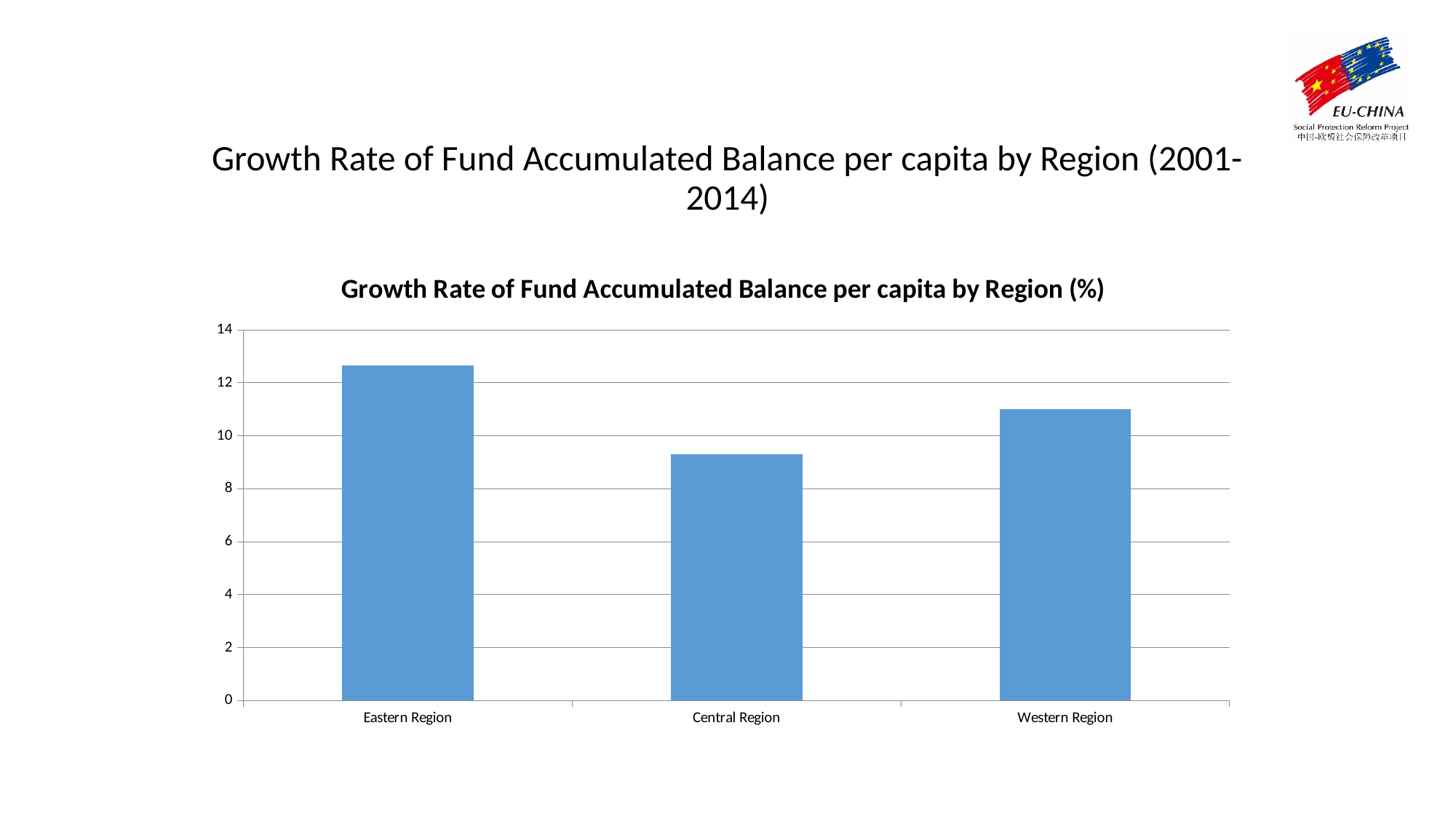
How many regions are plotted in the chart? 3 What kind of chart is shown on the slide? bar chart Which has a higher growth rate, the Eastern Region or the Western Region? Eastern Region Is the value for the Eastern Region greater or less than 12? greater Is the value for the Central Region greater or less than 8? greater Is the value for the Western Region greater or less than 10? greater Which region has the highest growth rate of fund accumulated balance per capita? Eastern Region What is the highest value shown on the vertical axis of the chart? 14 Which has a higher growth rate, the Central Region or the Western Region? Western Region What is the title of the chart? Growth Rate of Fund Accumulated Balance per capita by Region (%) Which region has the lowest growth rate of fund accumulated balance per capita? Central Region